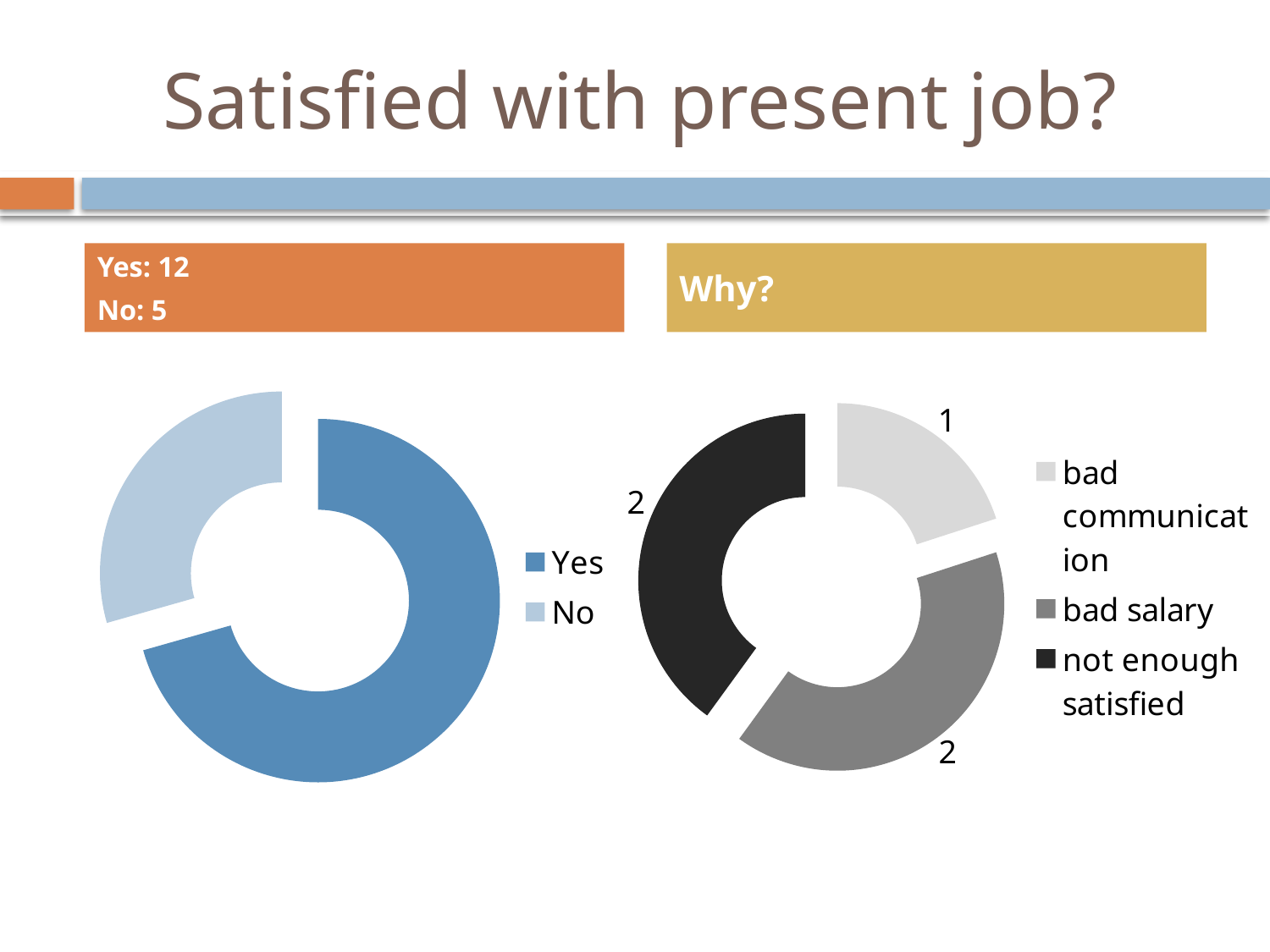
How many categories does the legend of the left chart list? 2 In the right chart (under "Why?"), what is the total of all three categories? 5 How many categories does the legend of the right chart (under "Why?") list? 3 What kind of chart is the left chart on the slide? doughnut chart In the left chart, how many people answered No? 5 In the right chart (under "Why?"), what is the value for bad communication? 1 In the right chart (under "Why?"), which category has the lowest value? bad communication In the left chart, how many people answered Yes? 12 In the left chart, which category is larger, Yes or No? Yes In the left chart, what is the difference between the Yes and No counts? 7 What kind of chart is the right chart (under "Why?") on the slide? doughnut chart In the right chart (under "Why?"), what is the value for bad salary? 2